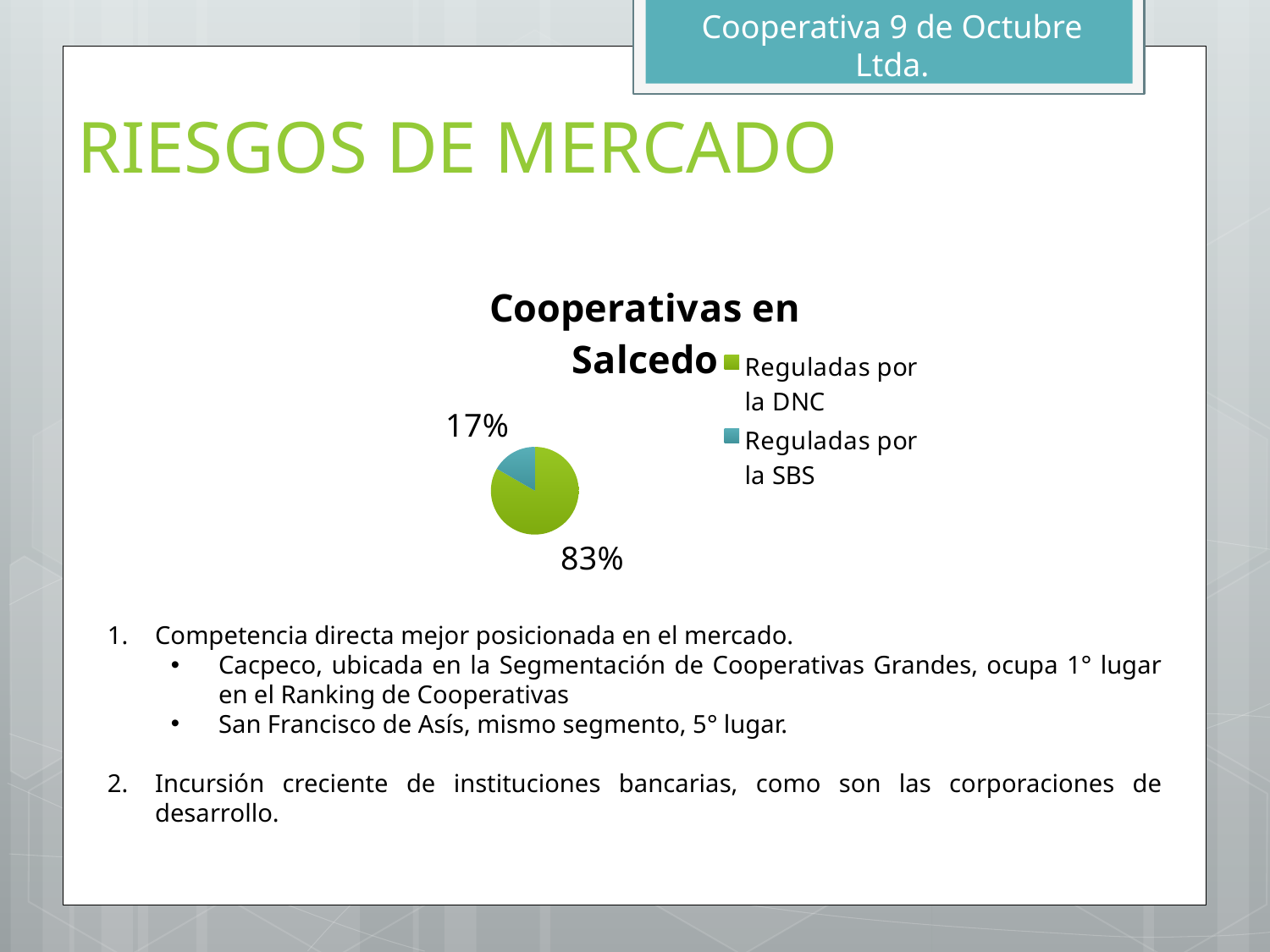
Which is larger, the slice for 'Reguladas por la DNC' or the slice for 'Reguladas por la SBS'? Reguladas por la DNC Which category has the smallest slice of the pie? Reguladas por la SBS What kind of chart is shown on the slide? pie chart What colour is the slice for 'Reguladas por la SBS'? blue How many slices does the pie chart have? 2 Which category has the largest slice of the pie? Reguladas por la DNC What share of the pie is 'Reguladas por la SBS'? 17% What is the title of the chart? Cooperativas en Salcedo How many entries does the legend list? 2 What is the difference in percentage points between 'Reguladas por la DNC' and 'Reguladas por la SBS'? 66 What share of the pie is 'Reguladas por la DNC'? 83%